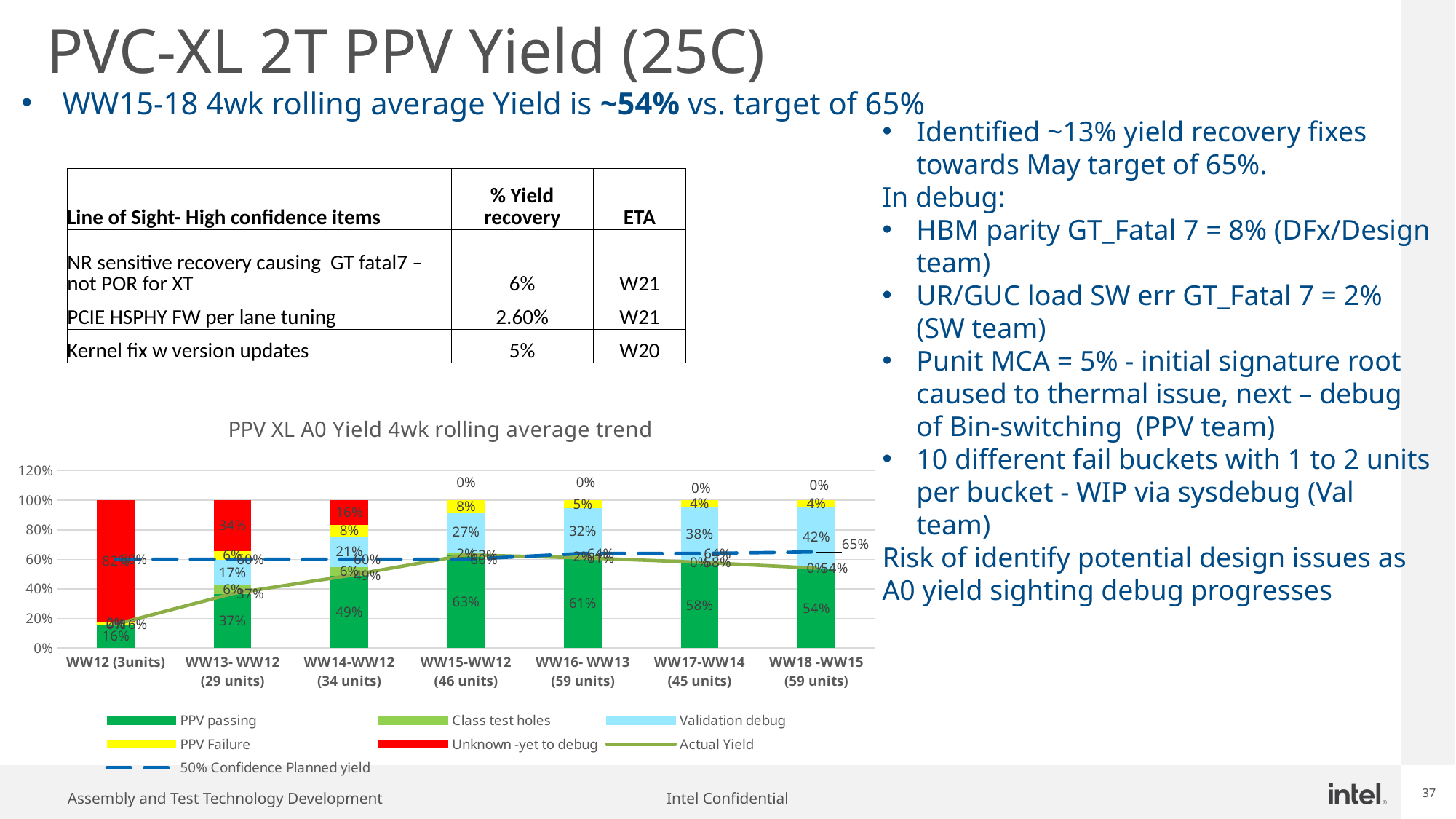
Which category has the highest PPV passing value? WW15-WW12 (46 units) How many categories are shown on the x axis of the chart? 7 What is the title of the chart on the slide? PPV XL A0 Yield 4wk rolling average trend What is the Validation debug value for WW17-WW14 (45 units)? 38% Does the PPV passing value rise or fall from WW12 (3units) to WW15-WW12 (46 units)? rise How many series does the chart legend list? 7 What is the PPV passing value for WW18 -WW15 (59 units)? 54% What is the difference between the PPV passing values for WW15-WW12 (46 units) and WW18 -WW15 (59 units)? 9% Which is larger, the Validation debug value for WW16- WW13 (59 units) or for WW18 -WW15 (59 units)? WW18 -WW15 (59 units) Which category has the lowest PPV passing value? WW12 (3units) What is the PPV passing value for WW15-WW12 (46 units)? 63% What type of chart is shown on the slide? combination bar and line chart